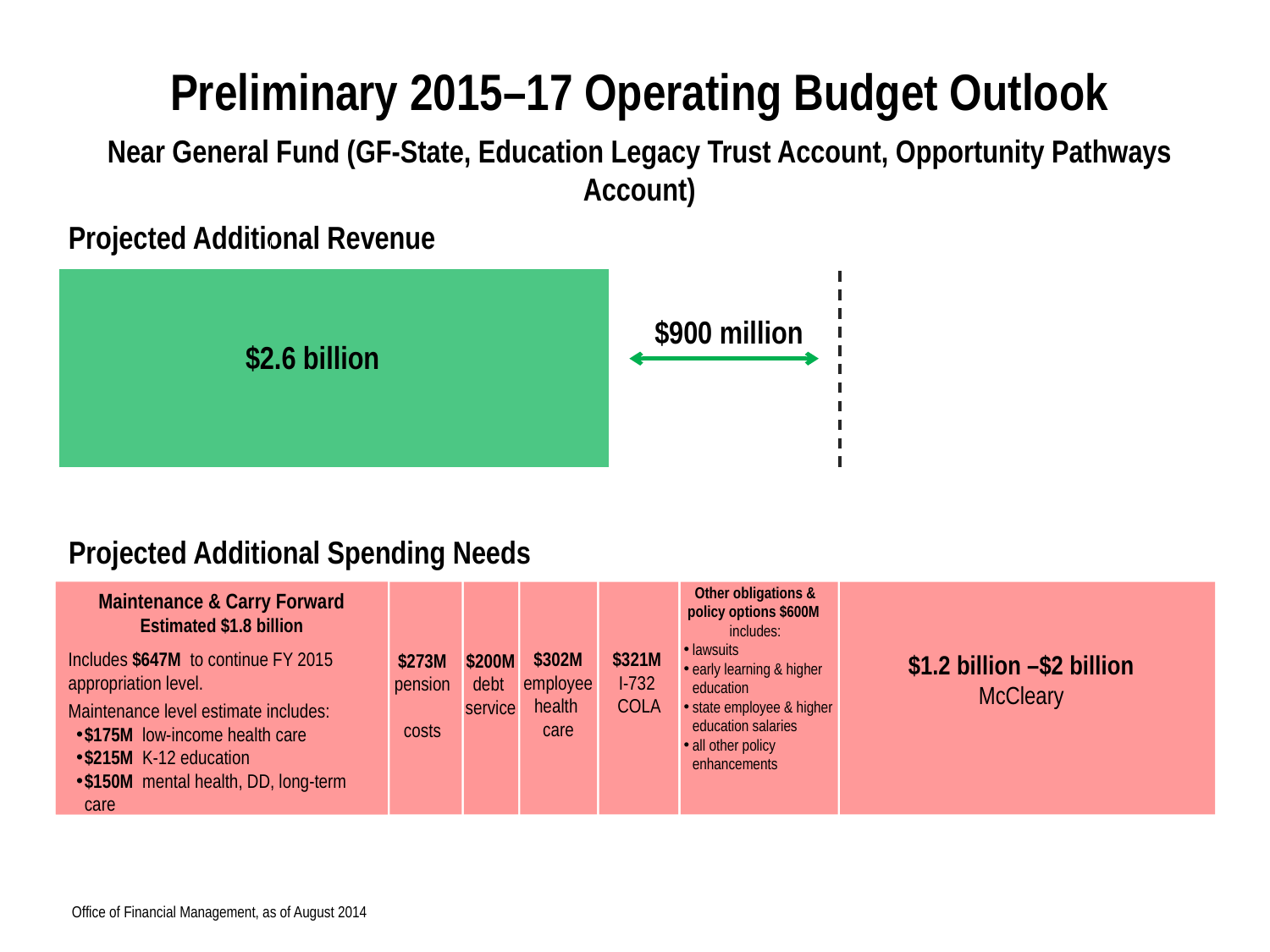
What is the value of the pension costs segment in the spending needs bar? $273M What is the value shown for Projected Additional Revenue? $2.6 billion What is the value of the I-732 COLA segment in the spending needs bar? $321M How many segments make up the Projected Additional Spending Needs bar? 7 What range is shown for McCleary in the spending needs bar? $1.2 billion –$2 billion What amount is given for Other obligations & policy options? $600M What is the difference between the employee health care segment and the debt service segment? $102M What amount is labelled on the arrow between the revenue bar and the dashed line? $900 million What is the value of the debt service segment in the spending needs bar? $200M Which is larger, the pension costs segment or the debt service segment? pension costs What is the estimated amount for Maintenance & Carry Forward in the Projected Additional Spending Needs bar? $1.8 billion What is the value of the employee health care segment in the spending needs bar? $302M